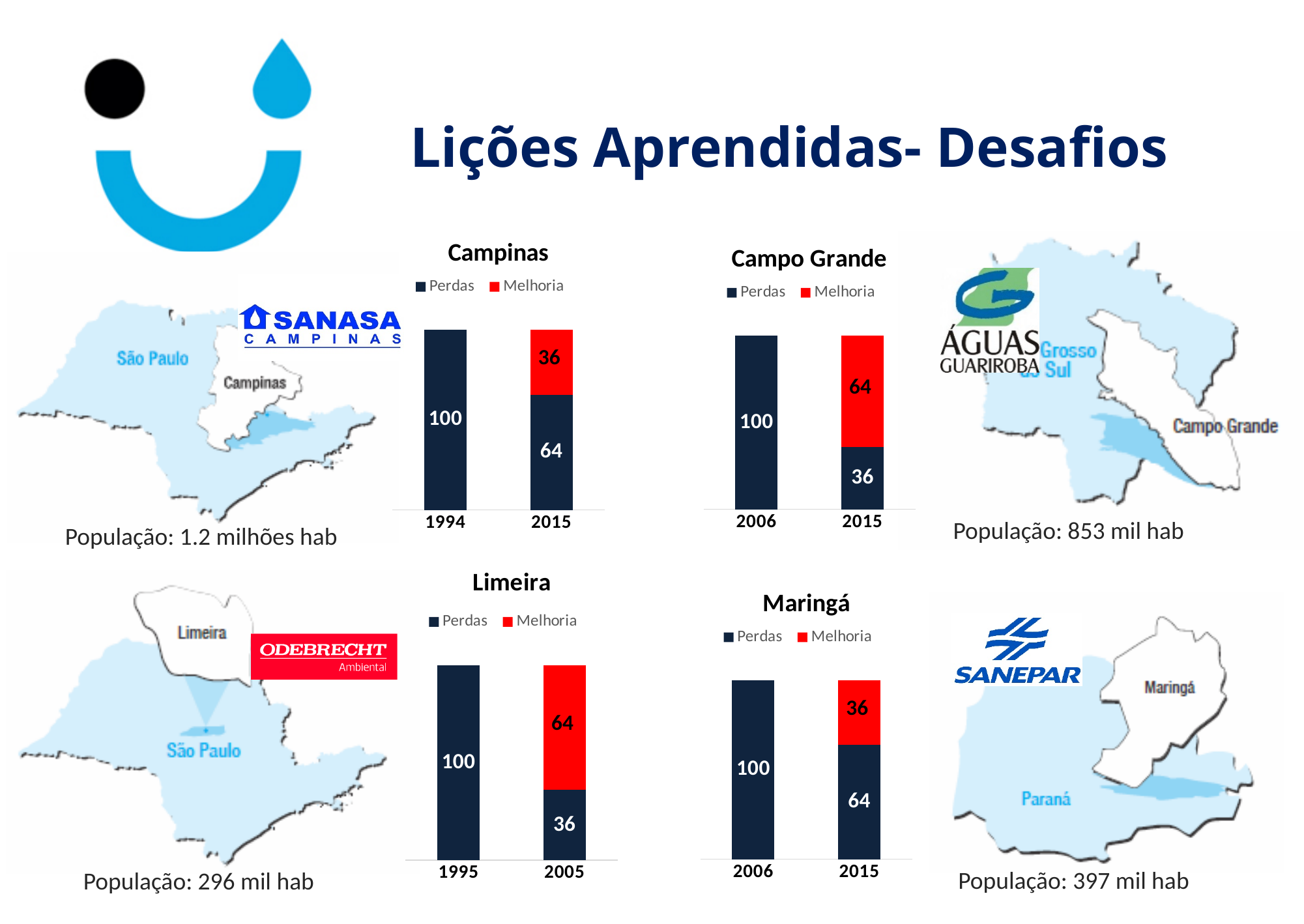
In the Limeira chart, what is the Perdas value for 1995? 100 In the Campinas chart, what is the Melhoria value for 2015? 36 In the Campinas chart, what is the Perdas value for 2015? 64 How many series does the legend of the Campo Grande chart list? 2 What kind of chart is the Limeira chart? Stacked bar chart In the Maringá chart, which year has the higher Perdas value, 2006 or 2015? 2006 In the Campo Grande chart, what is the Melhoria value for 2015? 64 In the Campinas chart, what is the difference between the Perdas values for 1994 and 2015? 36 In the Campo Grande chart, what is the Perdas value for 2015? 36 In the Limeira chart, which years are shown on the x axis? 1995 and 2005 In the Limeira chart, what is the total of the stacked bar for 2005? 100 In the Maringá chart, what is the Melhoria value for 2015? 36